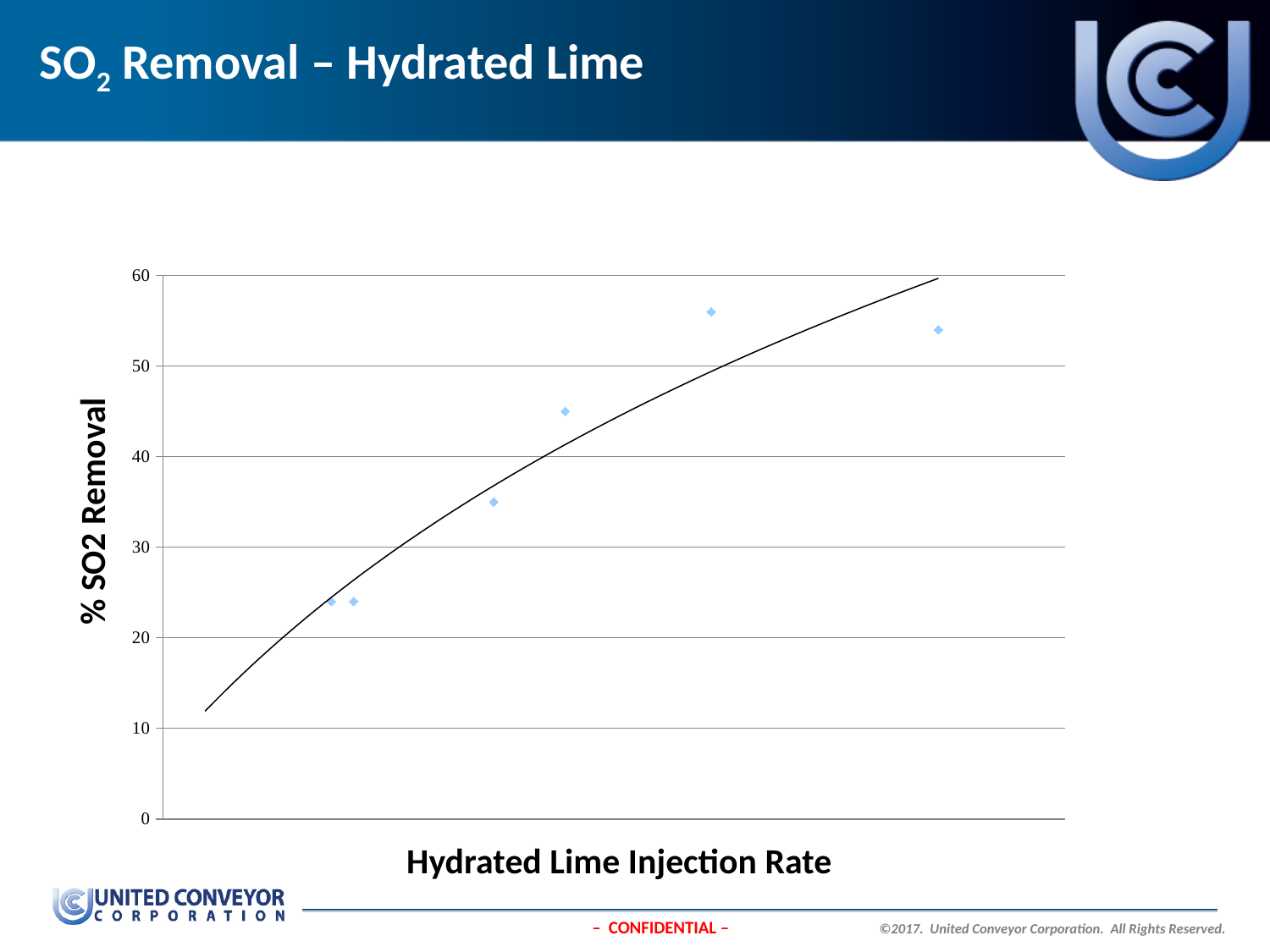
What kind of chart is shown on the slide? scatter chart Is the value of the third plotted point from the left greater or less than 40? less Do the plotted values rise or fall as the hydrated lime injection rate increases along the x axis? rise What is the title of the x axis? Hydrated Lime Injection Rate Is the value of the fourth plotted point from the left greater or less than 40? greater What is the title of the y axis? % SO2 Removal Is the value of the leftmost plotted point greater or less than 20? greater Does the fitted trendline on the chart rise or fall from left to right? rise How many data points are plotted on the chart? 6